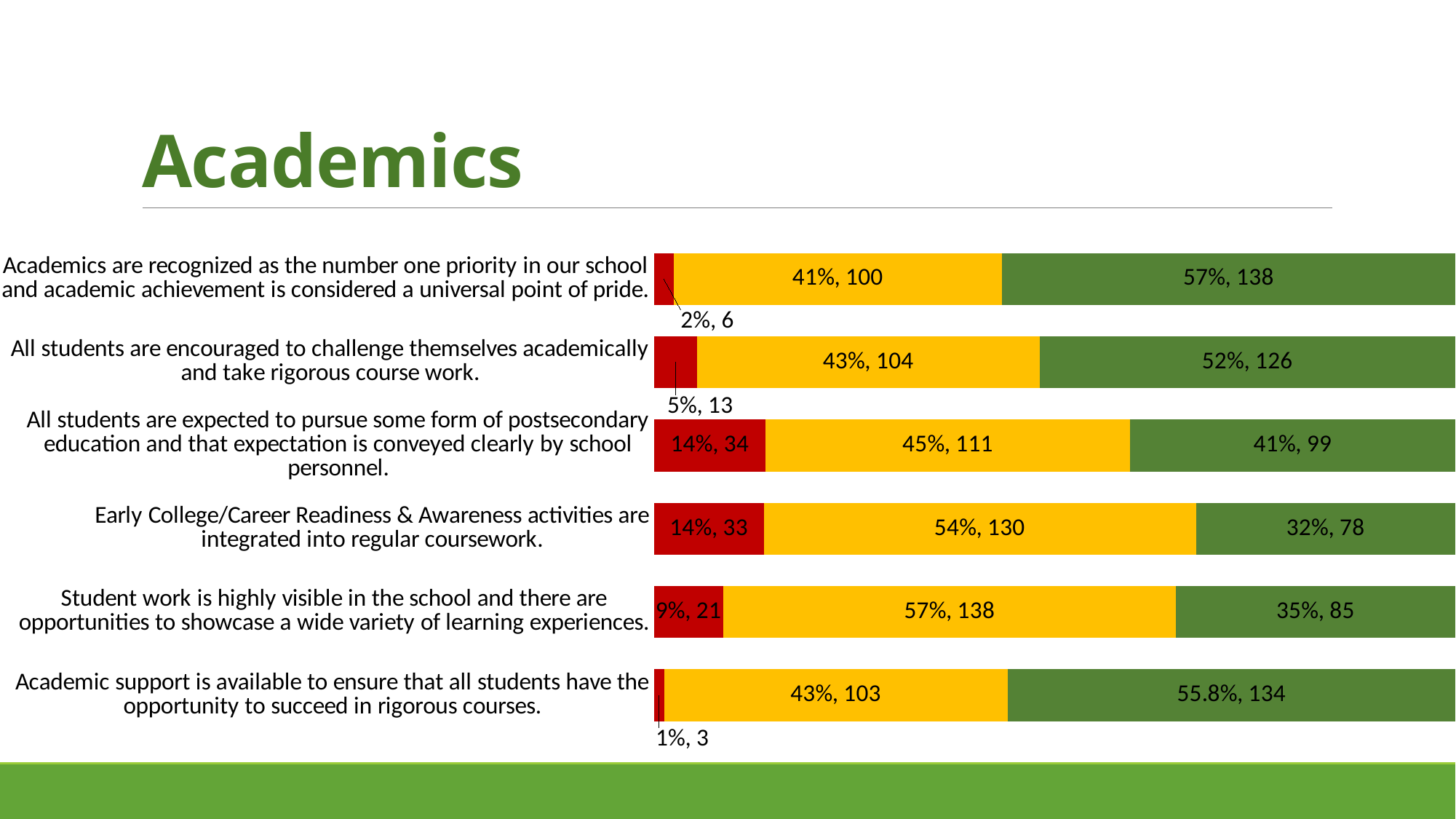
What is the difference between the yellow-segment count for "Student work is highly visible in the school..." (138) and the yellow-segment count for "Academics are recognized as the number one priority..." (100)? 38 What colour is the leftmost segment of each bar? Red Which statement has the largest yellow segment? Student work is highly visible in the school and there are opportunities to showcase a wide variety of learning experiences. What is the data label on the red segment for "All students are expected to pursue some form of postsecondary education and that expectation is conveyed clearly by school personnel."? 14%, 34 What kind of chart is shown on the slide? Stacked bar chart What is the data label on the green segment for "Academics are recognized as the number one priority in our school and academic achievement is considered a universal point of pride."? 57%, 138 What is the total count across all three segments for "Early College/Career Readiness & Awareness activities are integrated into regular coursework."? 241 How many statements (categories) are plotted in the chart? 6 Which statement has the largest green segment? Academics are recognized as the number one priority in our school and academic achievement is considered a universal point of pride. What is the data label on the yellow segment for "Early College/Career Readiness & Awareness activities are integrated into regular coursework."? 54%, 130 Which statement has the smallest red segment? Academic support is available to ensure that all students have the opportunity to succeed in rigorous courses. Which has the larger green-segment count: "All students are encouraged to challenge themselves academically and take rigorous course work." or "Early College/Career Readiness & Awareness activities are integrated into regular coursework."? All students are encouraged to challenge themselves academically and take rigorous course work.